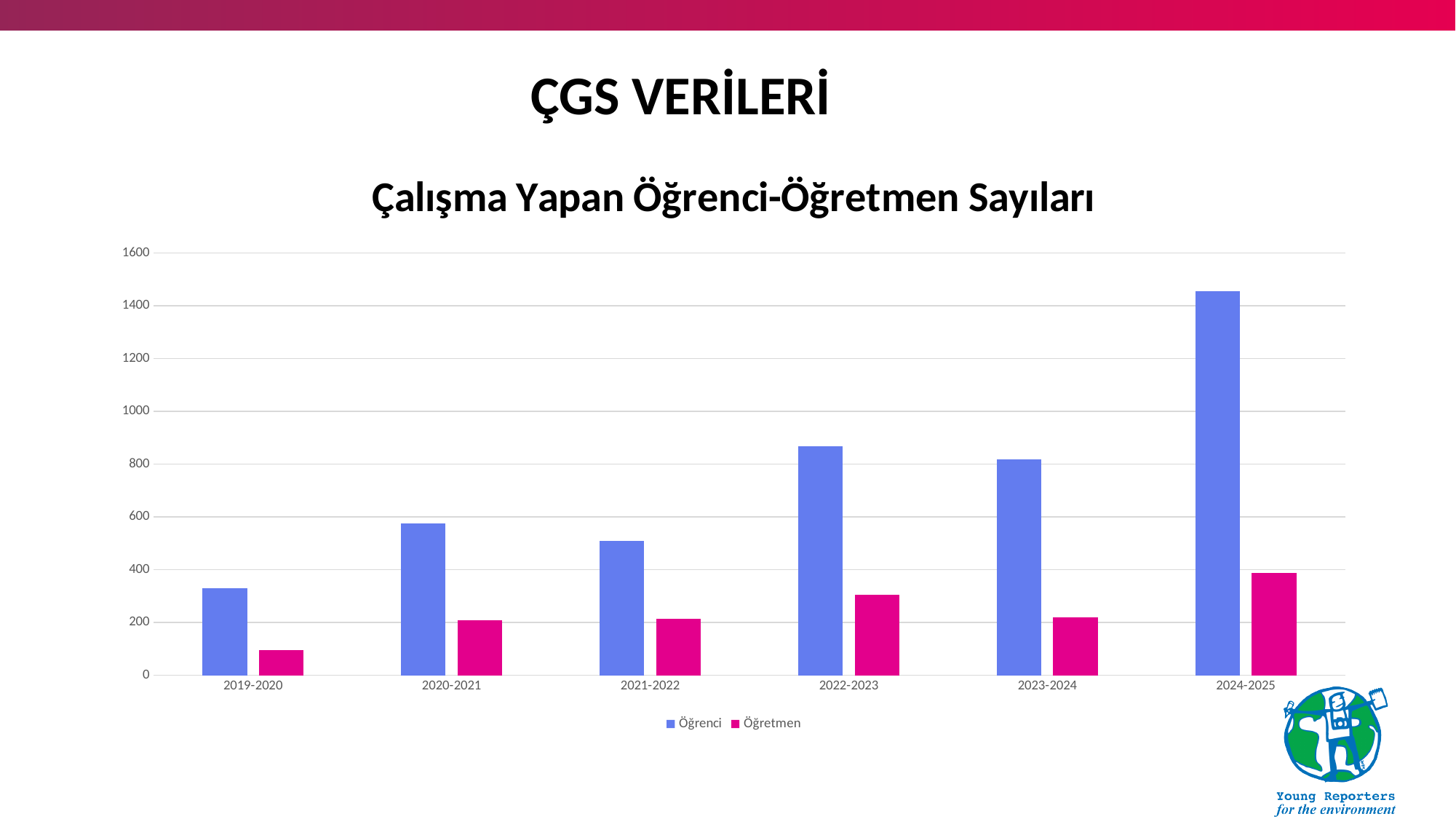
Is the Öğretmen value for 2019-2020 greater or less than 200? less What kind of chart is shown on the slide? bar chart Is the Öğrenci value for 2024-2025 greater or less than 1400? greater How many academic-year categories are shown on the x axis? 6 Which academic year has the lowest Öğretmen value? 2019-2020 Which academic year has the highest Öğrenci value? 2024-2025 Which academic year has the lowest Öğrenci value? 2019-2020 Which is larger, the Öğrenci value for 2020-2021 or for 2021-2022? 2020-2021 How many series does the legend list? 2 What is the title of the chart? Çalışma Yapan Öğrenci-Öğretmen Sayıları Which is larger, the Öğretmen value for 2022-2023 or for 2023-2024? 2022-2023 Is the Öğrenci value for 2022-2023 greater or less than 800? greater